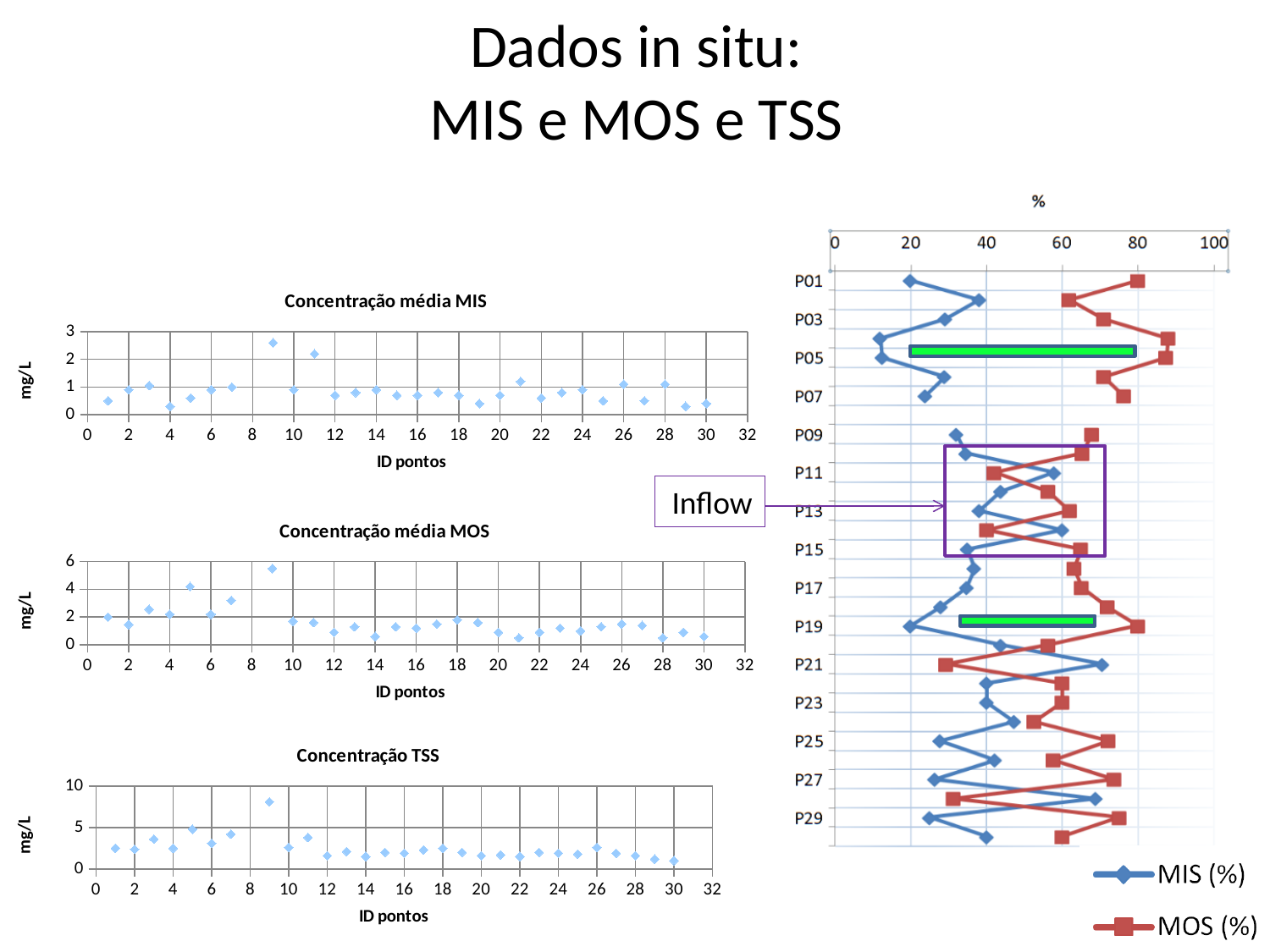
In the 'Concentração média MIS' chart, is the value at ID ponto 1 greater or less than 1? less How many series does the legend of the chart on the right list? 2 What kind of chart is the 'Concentração TSS' chart? Scatter chart In the 'Concentração média MOS' chart, is the value at ID ponto 9 greater or less than 4? greater In the 'Concentração TSS' chart, is the value at ID ponto 1 greater or less than 5? less In the chart on the right, which is larger at P01, MIS (%) or MOS (%)? MOS (%) In the 'Concentração TSS' chart, which ID ponto has the highest value? 9 What is the y-axis title of the 'Concentração média MOS' chart? mg/L In the 'Concentração média MIS' chart, which ID ponto has the highest value? 9 In the 'Concentração média MOS' chart, which ID ponto has the highest value? 9